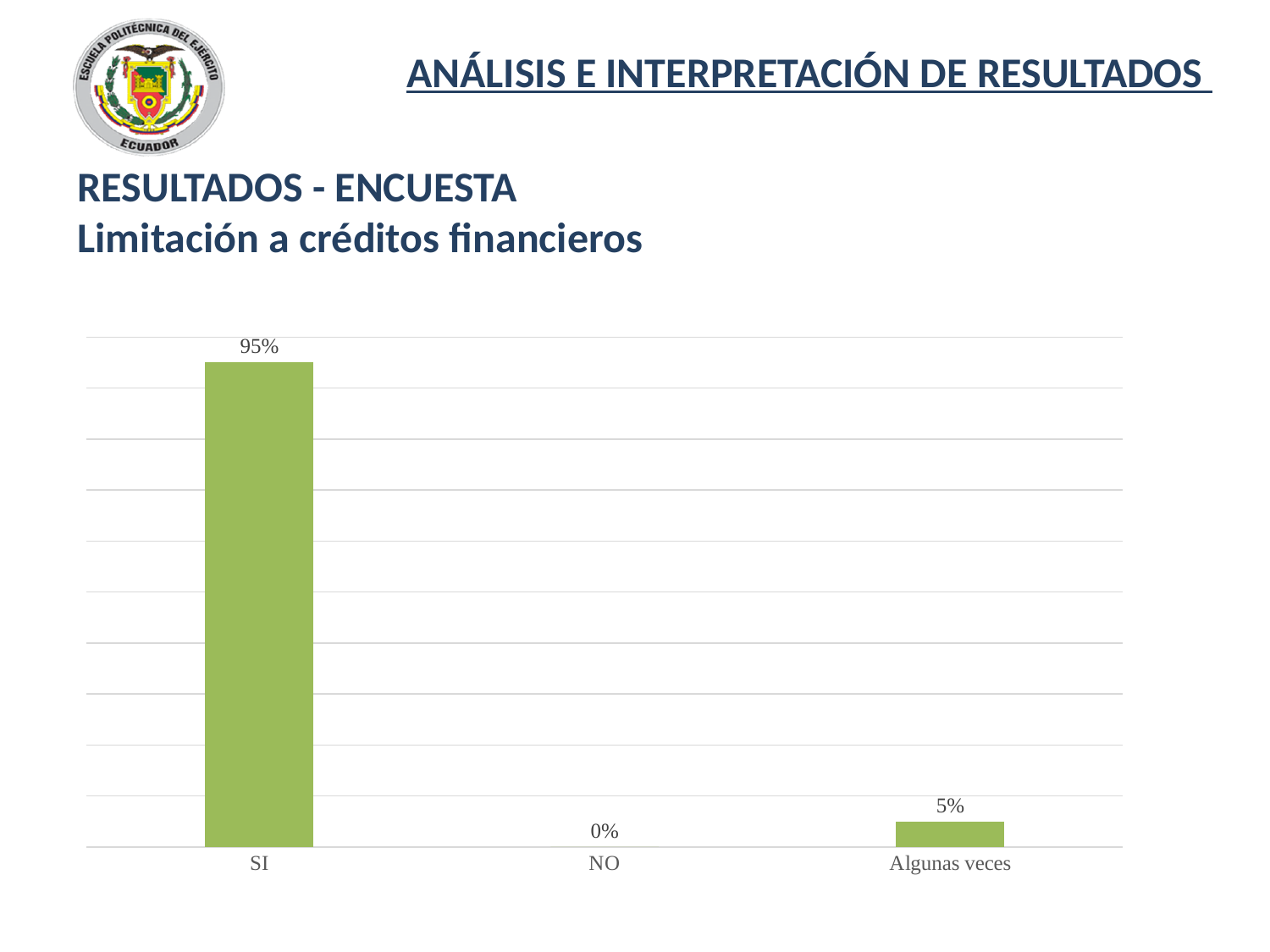
Which category has the lowest value? NO How many categories are shown on the x axis? 3 What is the difference between the values for SI and Algunas veces? 90% What colour are the bars in the chart? green What is the subtitle of the chart shown below 'RESULTADOS - ENCUESTA'? Limitación a créditos financieros What kind of chart is shown on the slide? bar chart Which is larger, the value for Algunas veces or the value for NO? Algunas veces Which category has the highest value? SI What is the value for NO? 0% What is the total of the values for SI, NO and Algunas veces? 100% What is the value for SI? 95% What is the value for Algunas veces? 5%